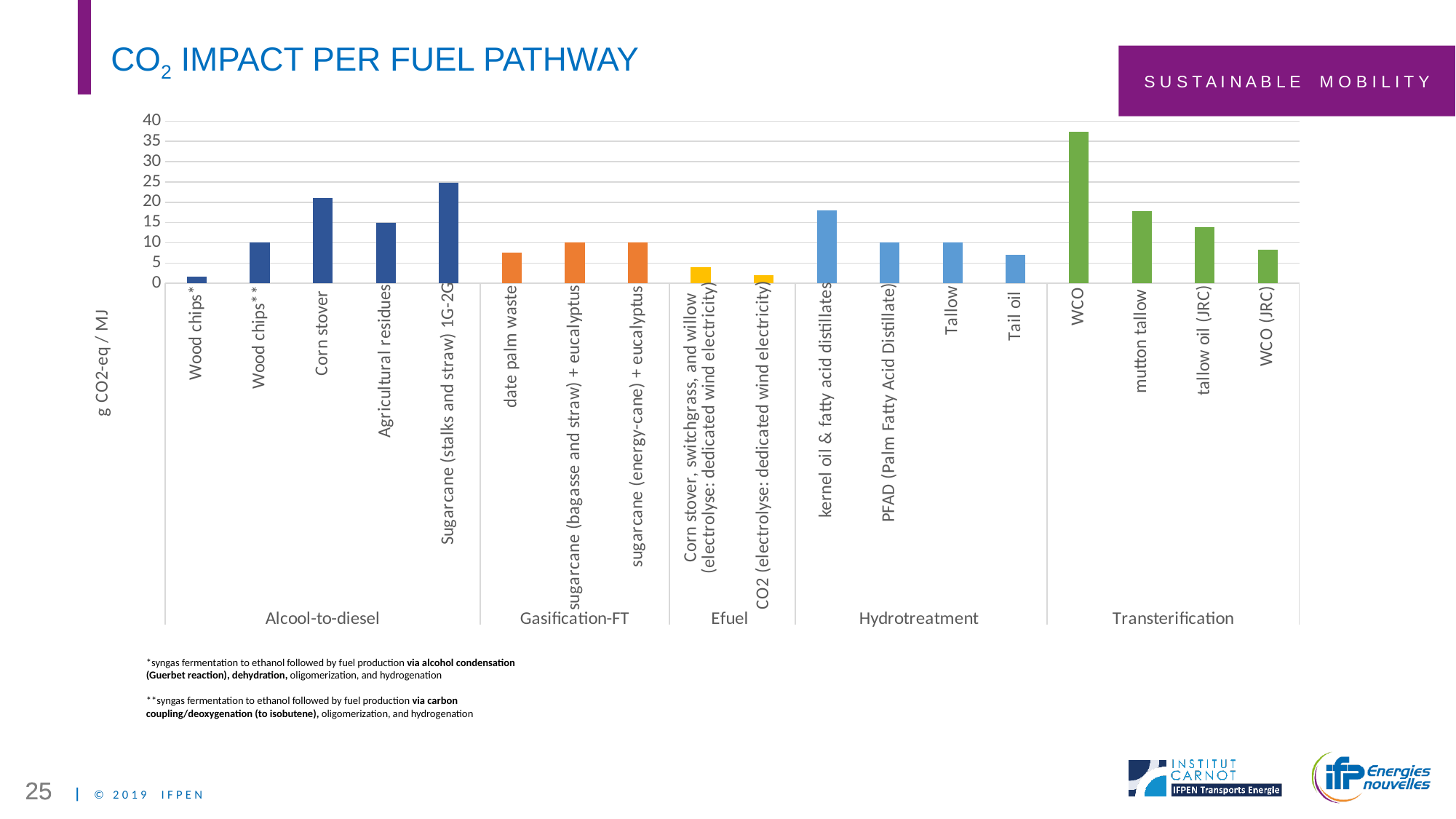
Is the value for tallow oil (JRC) greater or less than 10? greater Is the value for Corn stover in the Alcool-to-diesel group greater or less than 20? greater What kind of chart is shown on the slide? bar chart Is the value for CO2 (electrolyse: dedicated wind electricity) greater or less than 5? less How many fuel pathway bars are plotted in the chart? 18 Which has the larger CO2 impact, WCO or WCO (JRC)? WCO What is the y-axis label of the chart? g CO2-eq / MJ Which has the larger CO2 impact, Corn stover in the Alcool-to-diesel group or Agricultural residues? Corn stover Which fuel pathway has the highest CO2 impact in the chart? WCO